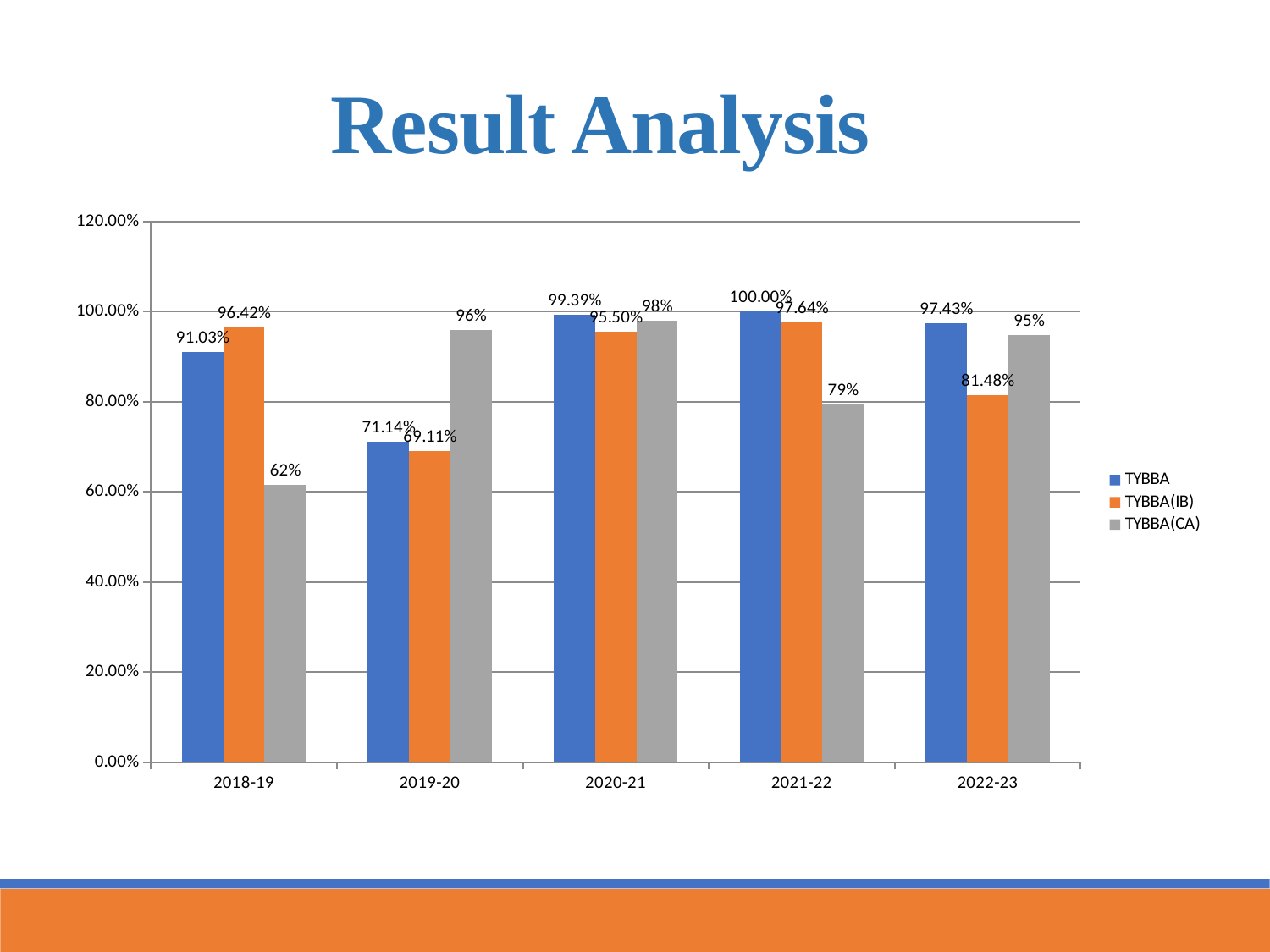
What is the TYBBA(CA) value for 2019-20? 96% What is the title of the slide? Result Analysis Which is larger for 2019-20, TYBBA or TYBBA(CA)? TYBBA(CA) What kind of chart is shown on the slide? bar chart In which year is the TYBBA series highest? 2021-22 How many years are shown on the x axis? 5 What is the TYBBA value for 2018-19? 91.03% What is the TYBBA(IB) value for 2022-23? 81.48% What is the difference between the TYBBA(IB) and TYBBA(CA) values for 2018-19? 34.42% How many series does the legend list? 3 Is the TYBBA(CA) value for 2021-22 greater or less than 80.00%? less In which year is the TYBBA(CA) series lowest? 2018-19